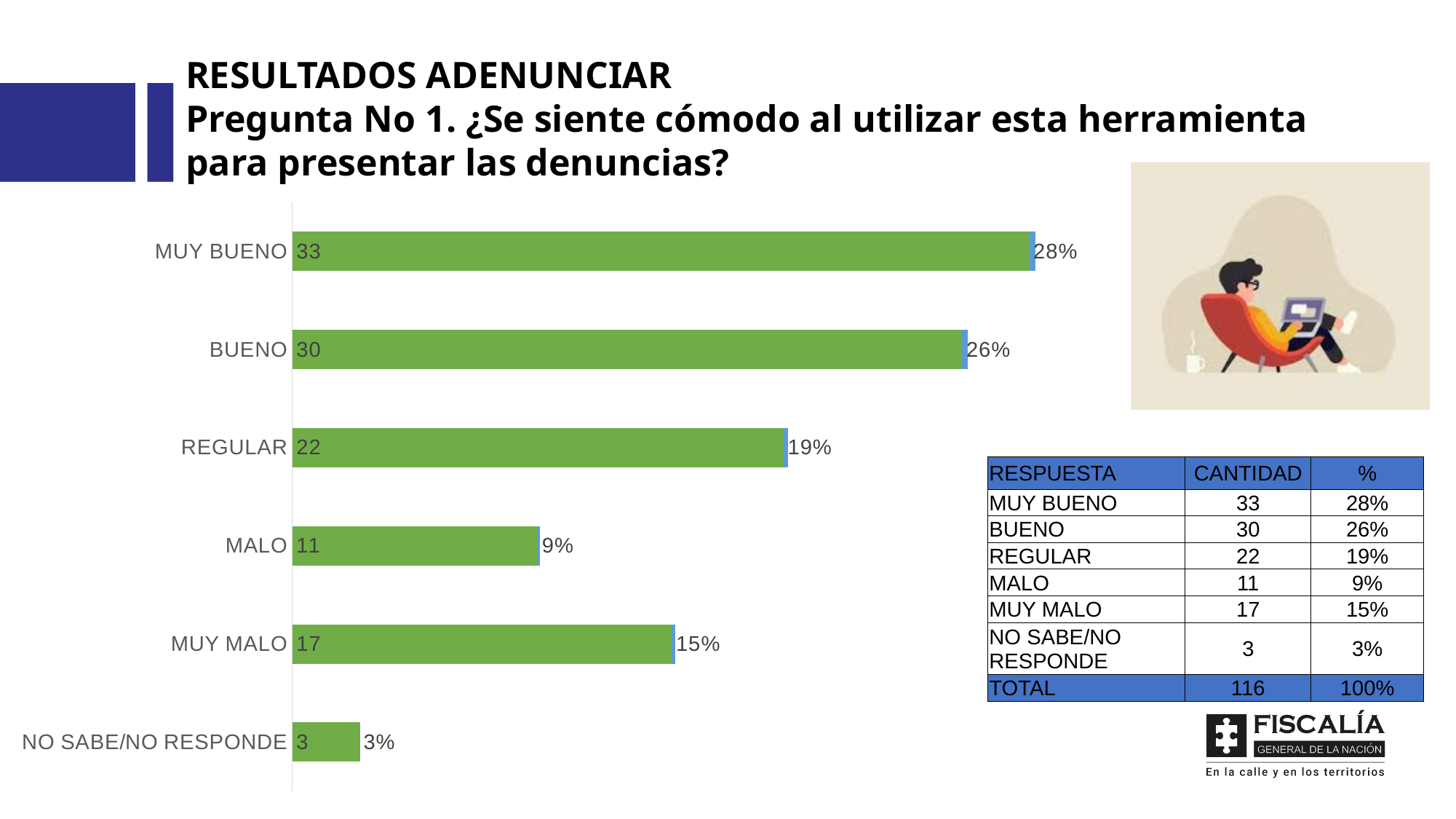
How many categories are shown in the bar chart? 6 What is the difference in count between MUY BUENO and BUENO? 3 Which category has the lowest count? NO SABE/NO RESPONDE What kind of chart is shown on the slide? Bar chart What is the count for MUY BUENO? 33 What is the count for MUY MALO? 17 What percentage is shown for REGULAR? 19% Which has a larger count, MALO or MUY MALO? MUY MALO Which category has the highest count? MUY BUENO What colour are the bars in the chart? Green What is the difference in count between REGULAR and MALO? 11 What is the total count shown in the table? 116